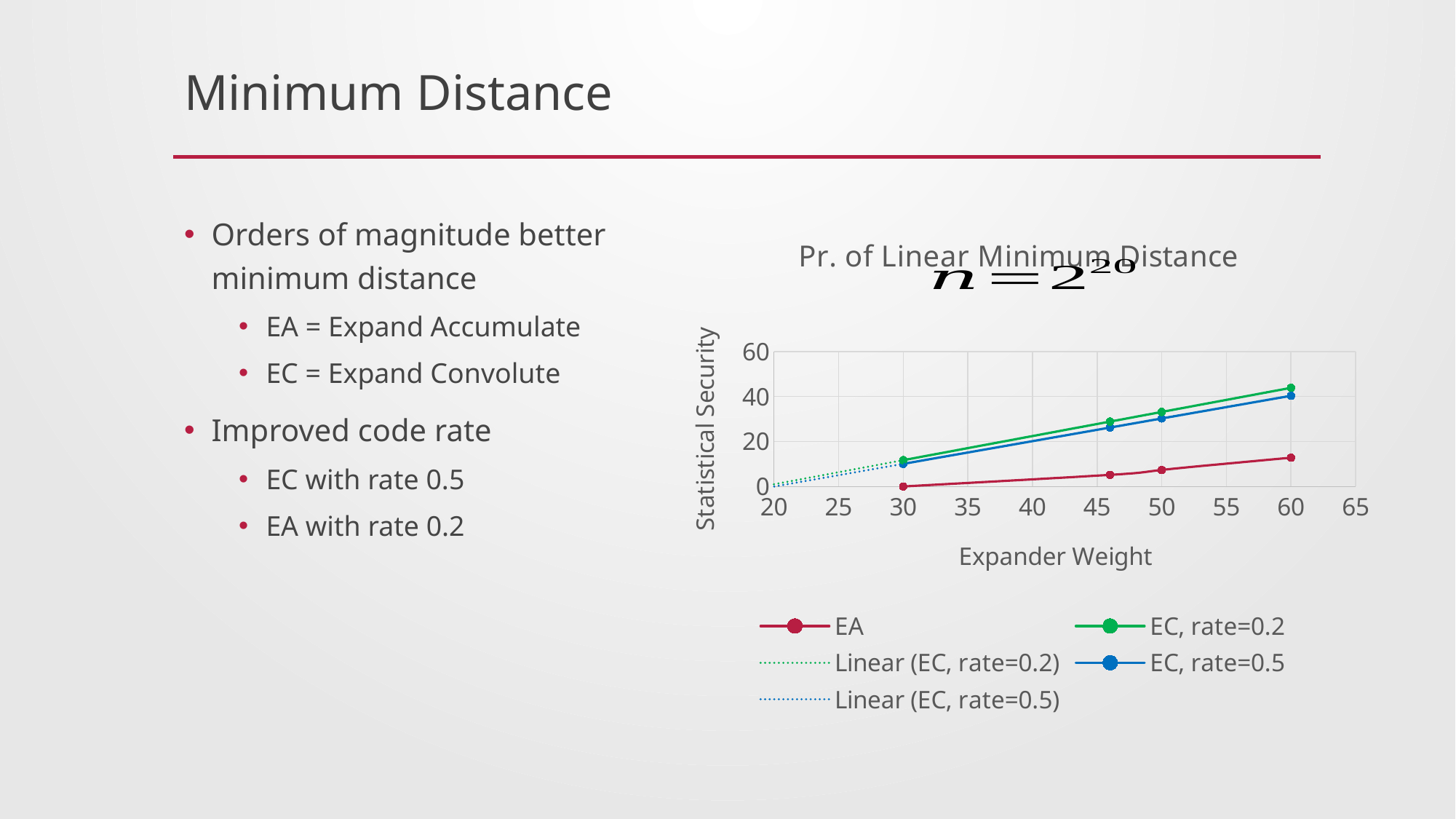
Is the value for EC, rate=0.2 at expander weight 30 greater or less than 20? less What is the label of the x axis of the chart? Expander Weight What kind of chart is shown on the slide? line chart Which series has the lowest value at expander weight 60? EA How many data points are plotted for the EA series? 4 Is the value for EC, rate=0.5 at expander weight 46 greater or less than 20? greater What is the title of the chart? Pr. of Linear Minimum Distance Is the value for EA at expander weight 60 greater or less than 20? less Do the values for EC, rate=0.5 rise or fall as expander weight increases? rise How many entries does the chart legend list? 5 At expander weight 60, which series has the higher value: EA or EC, rate=0.2? EC, rate=0.2